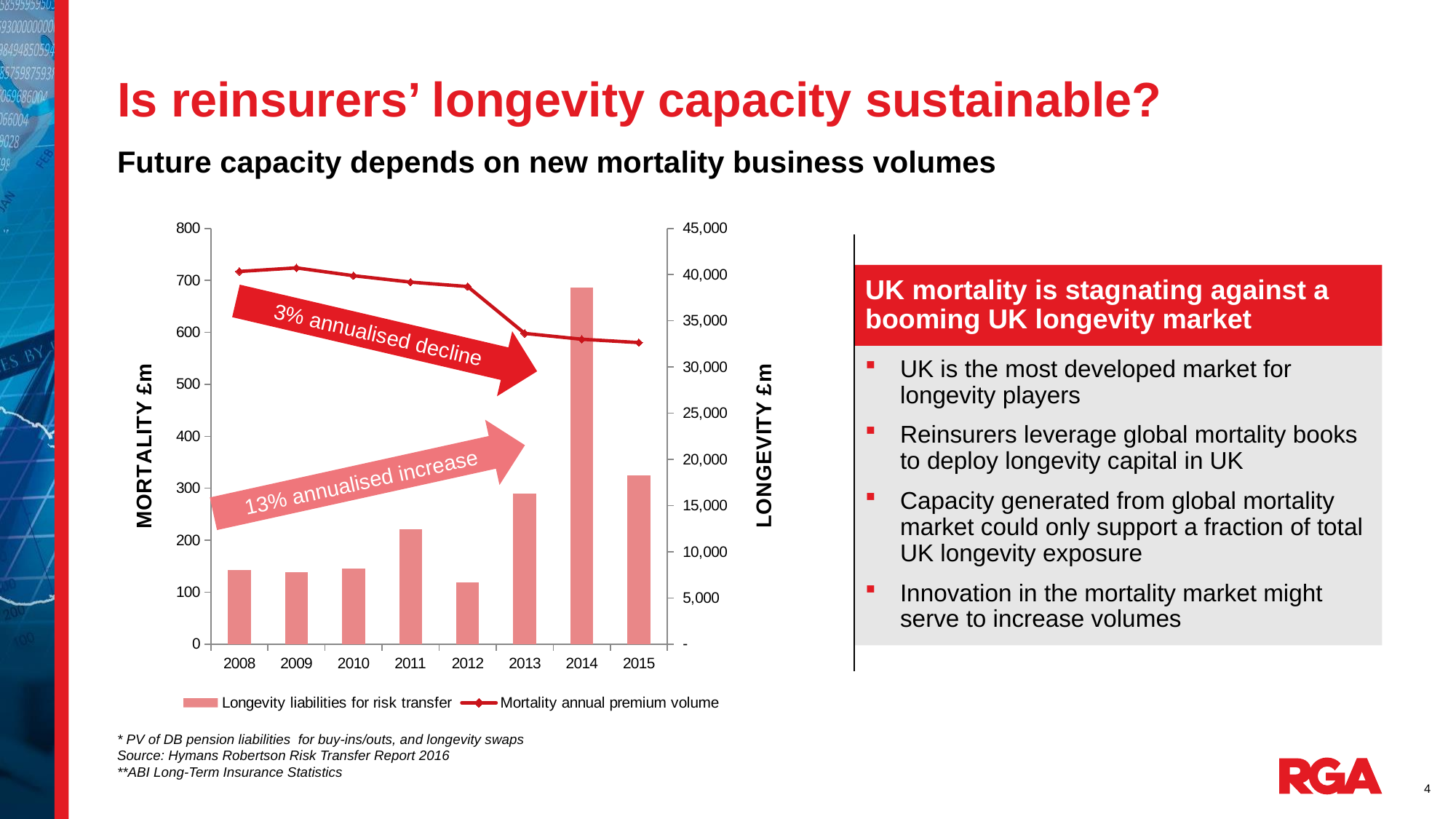
Is the Longevity liabilities for risk transfer value for 2012 greater or less than 10,000? less How many series does the chart legend list? 2 Does the Mortality annual premium volume line rise or fall from 2008 to 2015? Fall Which year has the larger Longevity liabilities for risk transfer bar, 2010 or 2011? 2011 What type of chart is shown on the slide? Combination bar and line chart How many years are shown on the x axis of the chart? 8 In which year is the bar for Longevity liabilities for risk transfer highest? 2014 Is the Mortality annual premium volume for 2013 greater or less than 650? less In which year is the bar for Longevity liabilities for risk transfer lowest? 2012 Is the Mortality annual premium volume for 2008 greater or less than 700? greater What is the label on the left vertical axis of the chart? MORTALITY £m